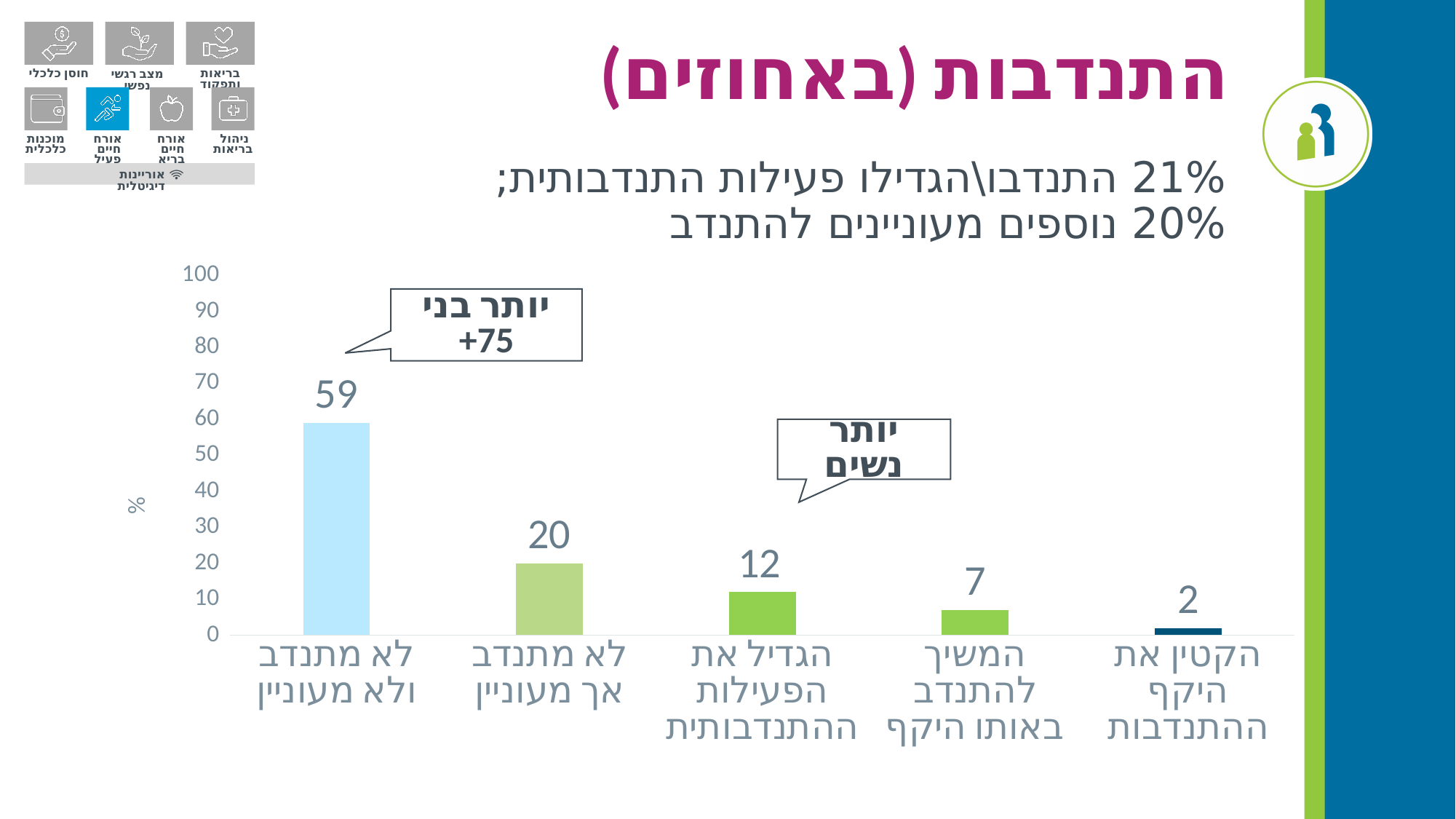
What kind of chart is shown on the slide? Bar chart Which category has the lowest value? הקטין את היקף ההתנדבות How many categories are shown in the chart? 5 What is the value for the category "לא מתנדב אך מעוניין"? 20 Which is larger, the value for "הגדיל את הפעילות ההתנדבותית" or the value for "המשיך להתנדב באותו היקף"? הגדיל את הפעילות ההתנדבותית What is the title of the slide? התנדבות (באחוזים) What is the value for the category "הקטין את היקף ההתנדבות"? 2 What is the difference between the values for "לא מתנדב ולא מעוניין" and "לא מתנדב אך מעוניין"? 39 What is the value for the category "לא מתנדב ולא מעוניין"? 59 What is the value for the category "הגדיל את הפעילות ההתנדבותית"? 12 Which category has the highest value? לא מתנדב ולא מעוניין What is the value for the category "המשיך להתנדב באותו היקף"? 7